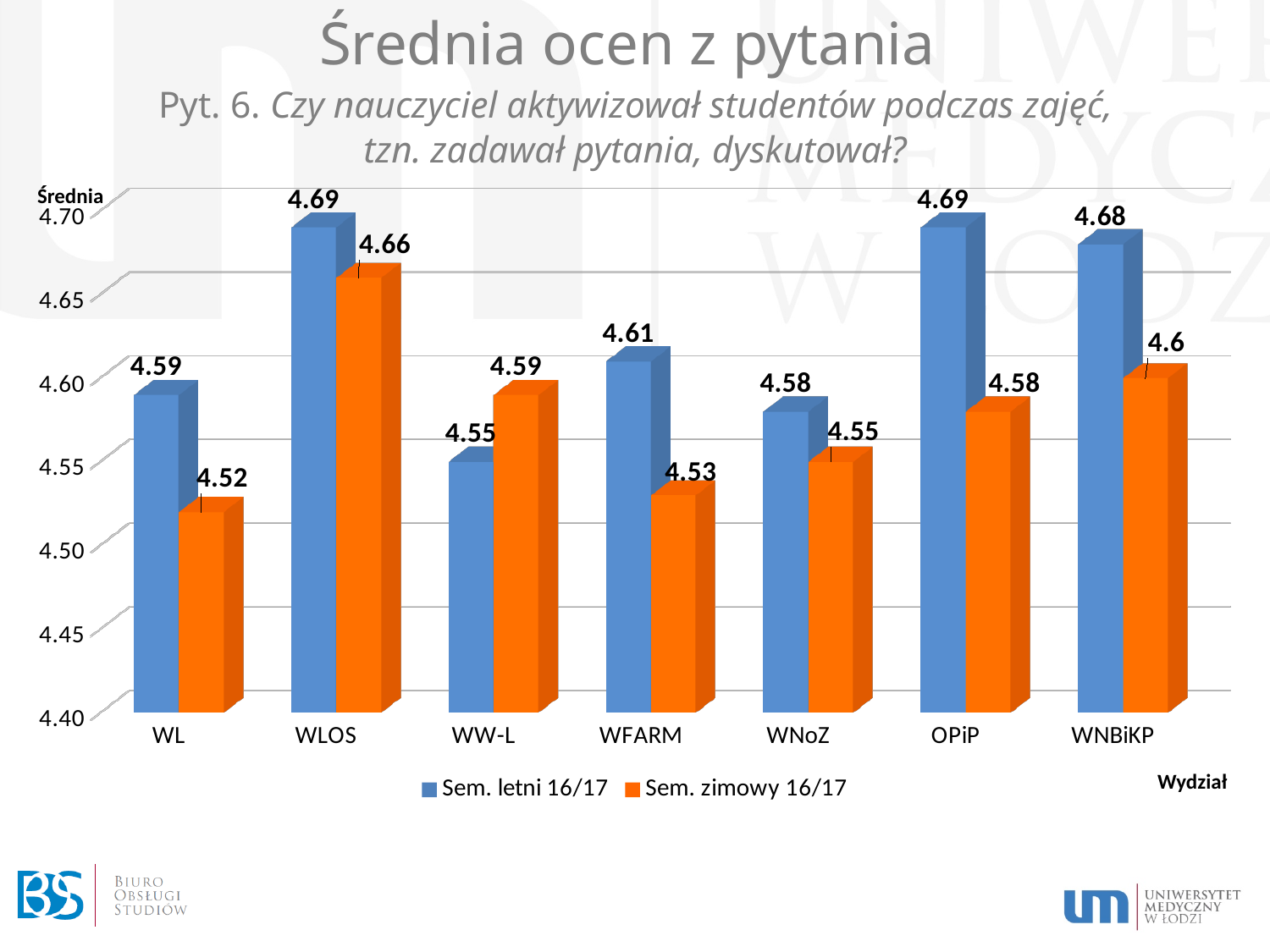
How many series does the legend list? 2 Which category has the lowest value in the Sem. zimowy 16/17 series? WL What kind of chart is shown on the slide? bar chart Which category has the highest value in the Sem. zimowy 16/17 series? WLOS How many categories (wydziały) are shown on the x axis? 7 Is the Sem. zimowy 16/17 value for WFARM greater or less than 4.55? less What is the difference between the Sem. letni 16/17 and Sem. zimowy 16/17 values for OPiP? 0.11 What is the value for OPiP in the Sem. zimowy 16/17 series? 4.58 What is the value for WNBiKP in the Sem. zimowy 16/17 series? 4.6 Which category has the lowest value in the Sem. letni 16/17 series? WW-L For WW-L, which series has the larger value: Sem. letni 16/17 or Sem. zimowy 16/17? Sem. zimowy 16/17 What is the value for WL in the Sem. letni 16/17 series? 4.59